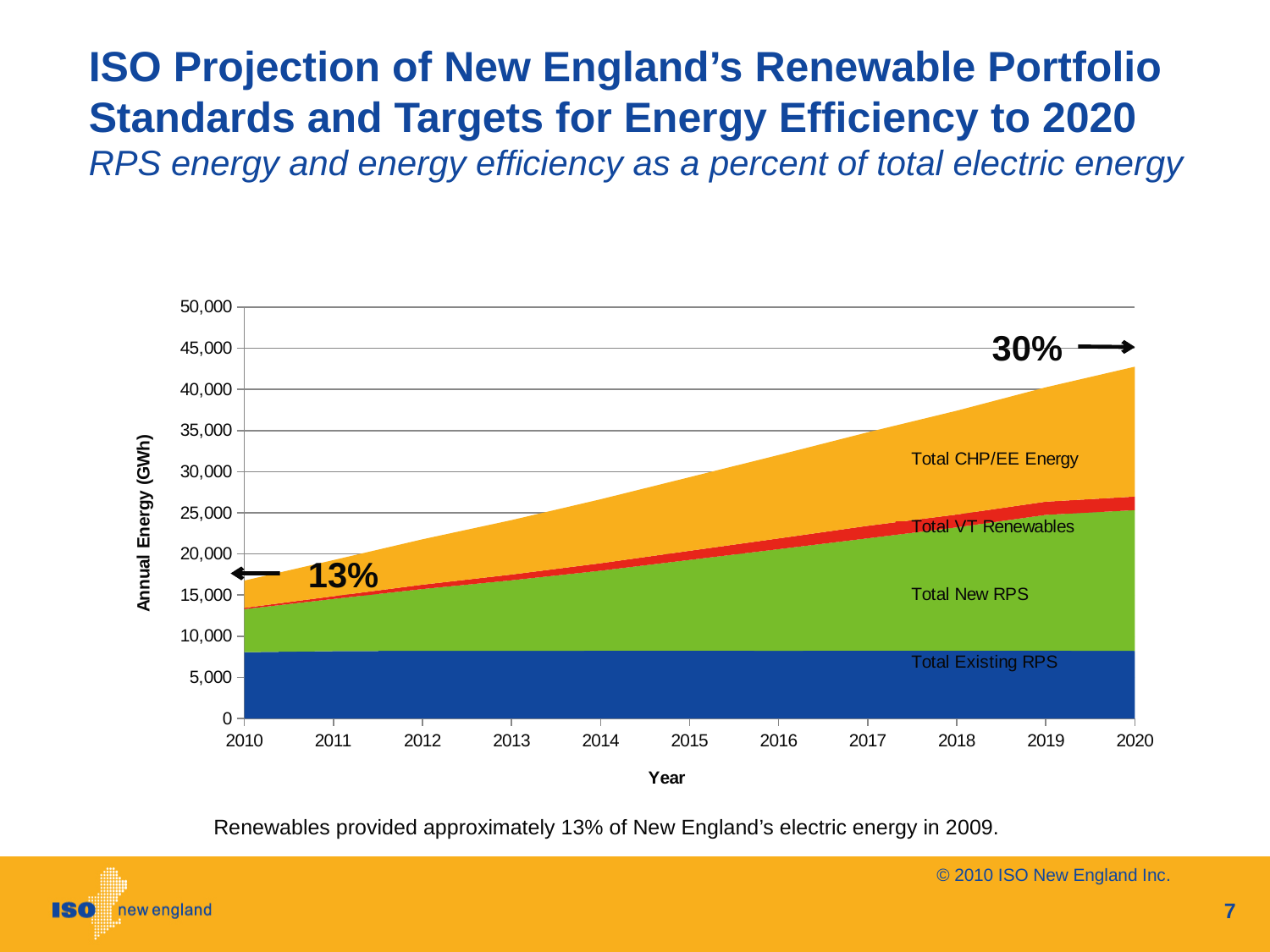
How many years are plotted along the x axis of the chart? 11 Which series is the thinnest band in the chart? Total VT Renewables In which year is the total stacked annual energy lowest? 2010 What kind of chart is shown on the slide? Stacked area chart What is the label on the y axis of the chart? Annual Energy (GWh) Is the total stacked annual energy in 2020 greater or less than 40,000 GWh? greater Does the total stacked annual energy rise or fall from 2010 to 2020? Rises In which year is the total stacked annual energy highest? 2020 What percentage is annotated at the 2020 end of the chart? 30% Is the value of Total Existing RPS greater or less than 10,000 GWh? less Is the total stacked annual energy in 2010 greater or less than 20,000 GWh? less How many series are stacked in the chart? 4